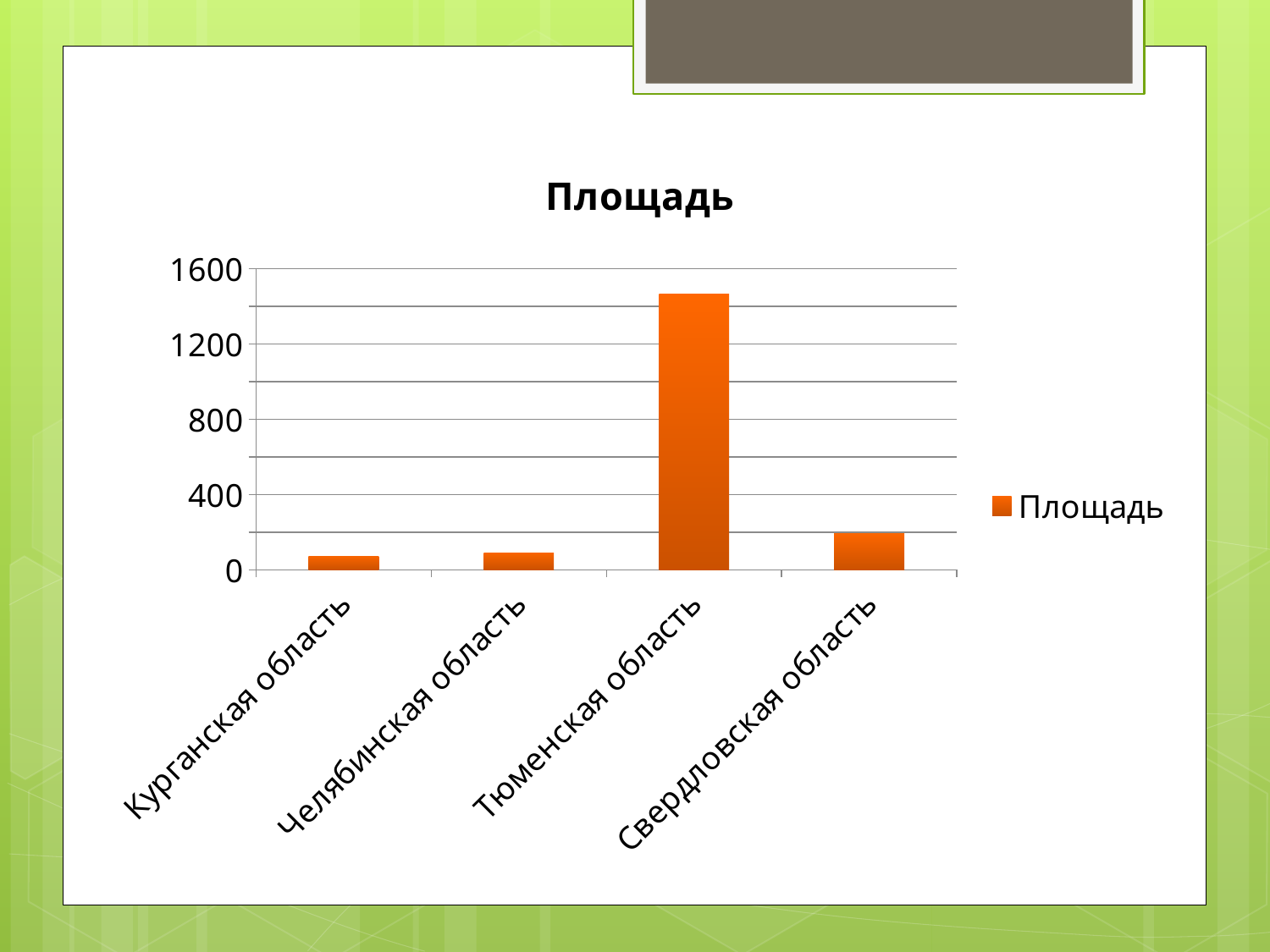
What is the title of the chart? Площадь Is the value for Челябинская область greater or less than 800? less Is the value for Свердловская область greater or less than 400? less How many categories are shown on the x axis of the chart? 4 Which is larger, the value for Свердловская область or the value for Курганская область? Свердловская область Is the value for Курганская область greater or less than 400? less Which is larger, the value for Тюменская область or the value for Свердловская область? Тюменская область What is the name of the series shown in the legend? Площадь What kind of chart is shown on the slide? bar chart Which category has the highest value? Тюменская область How many series does the legend list? 1